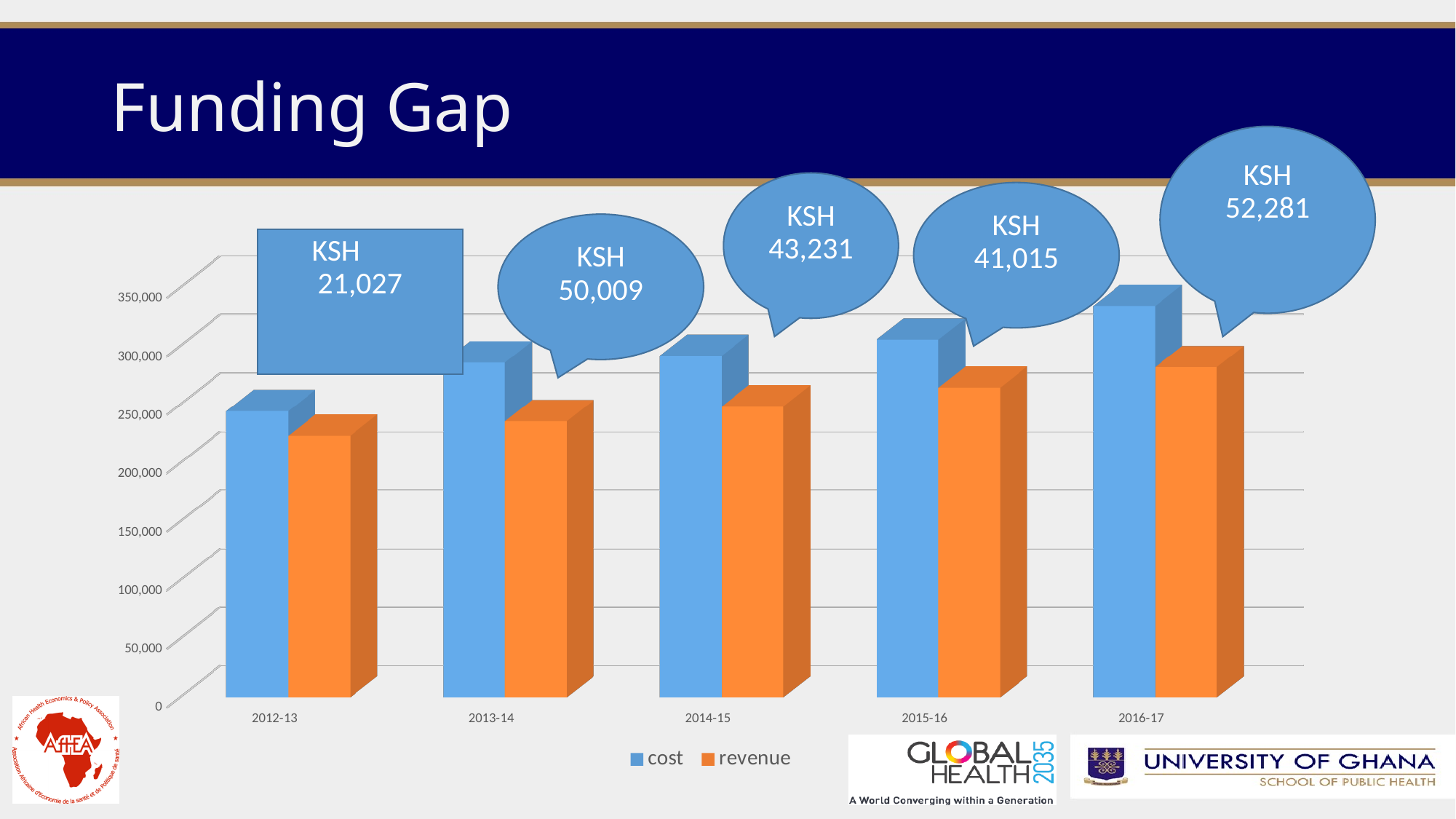
How many year categories are shown on the x axis? 5 Is the revenue value for 2016-17 greater or less than 250,000? greater Do the cost bars rise or fall from 2012-13 to 2016-17? rise Is the revenue value for 2012-13 greater or less than 250,000? less What kind of chart is shown on the slide? bar chart What funding gap value is shown in the callout above 2013-14? KSH 50,009 Which year has the highest cost bar? 2016-17 Which year has the lowest revenue bar? 2012-13 What funding gap value is shown in the callout above 2016-17? KSH 52,281 In 2016-17, which is larger, cost or revenue? cost How many series does the legend list? 2 Is the cost value for 2016-17 greater or less than 300,000? greater